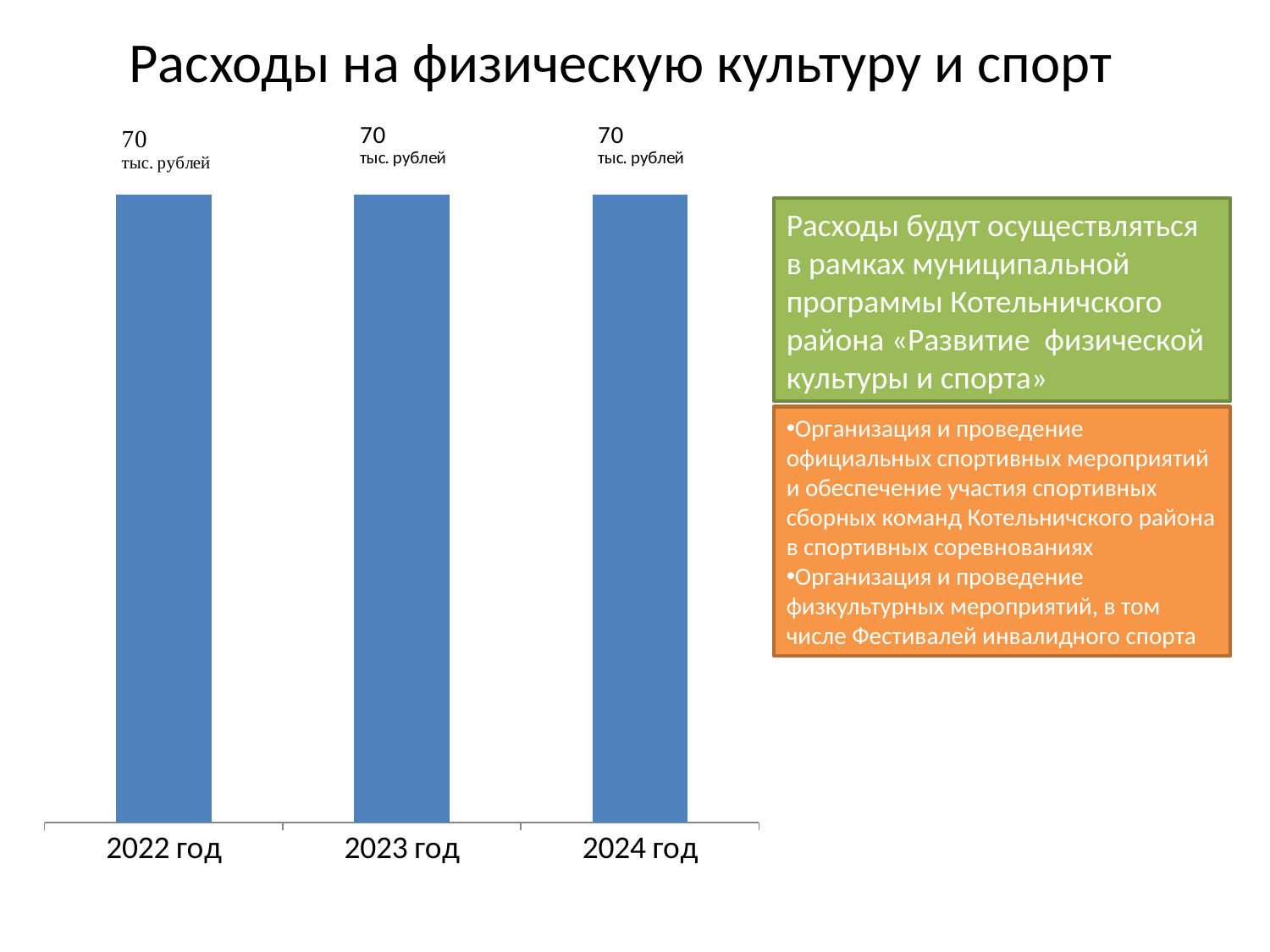
What is the value for 2023 год? 70 тыс. рублей Do the values rise, fall, or stay the same from 2022 год to 2024 год? Stay the same What is the value for 2022 год? 70 тыс. рублей Is the value for 2022 год larger than, smaller than, or equal to the value for 2024 год? Equal Which years are shown on the x axis of the chart? 2022 год, 2023 год, 2024 год What is the difference between the values for 2023 год and 2022 год? 0 What kind of chart is shown on the slide? Bar chart What is the difference between the values for 2024 год and 2022 год? 0 What colour are the bars in the chart? Blue How many bars (categories) are shown in the chart? 3 What is the value for 2024 год? 70 тыс. рублей What is the title of the slide containing the chart? Расходы на физическую культуру и спорт